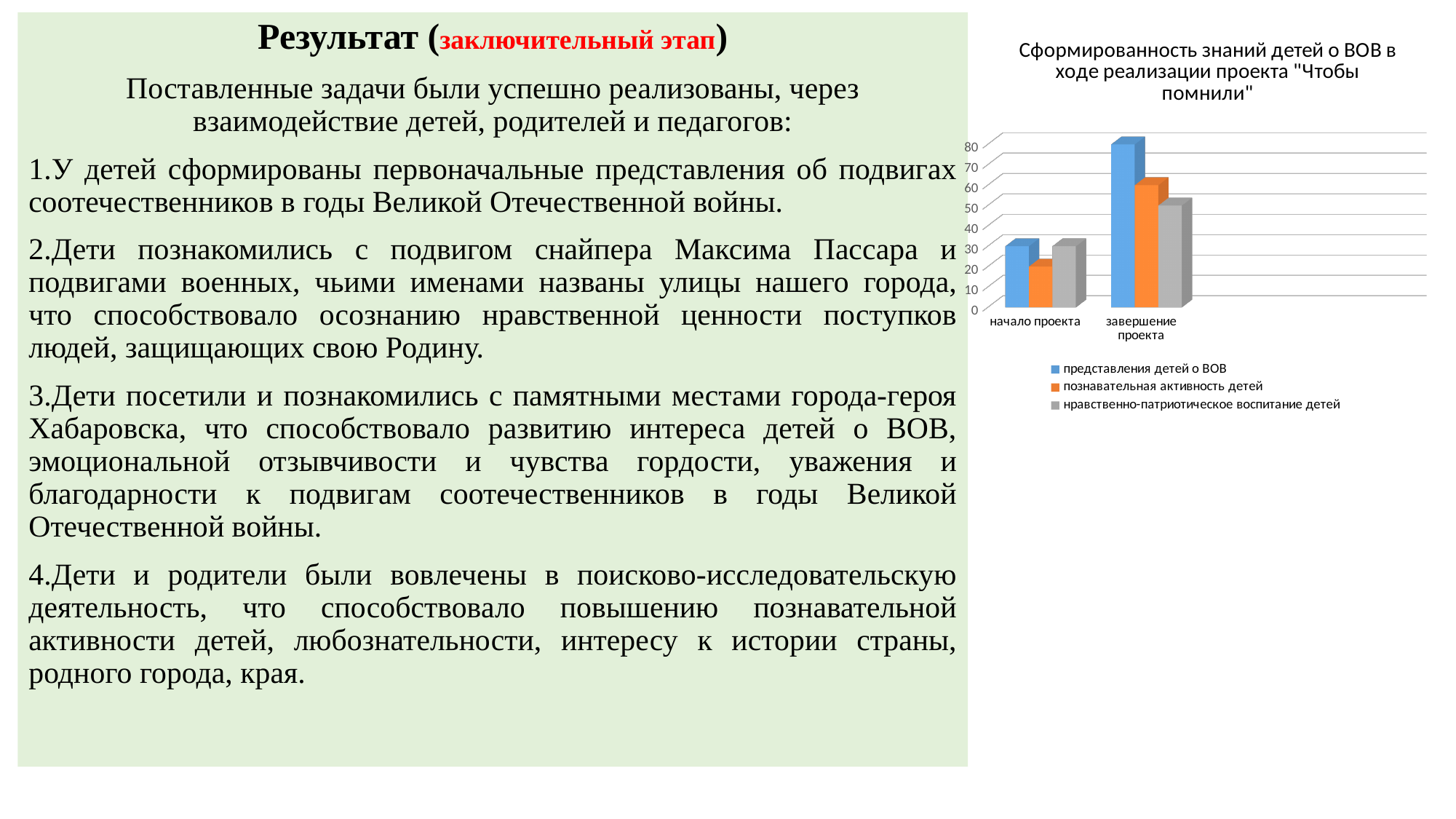
For "представления детей о ВОВ", which category has the larger value: "начало проекта" or "завершение проекта"? завершение проекта Do the values for each series rise or fall from "начало проекта" to "завершение проекта"? rise Is the value for "представления детей о ВОВ" at "завершение проекта" greater or less than 70? greater Which series has the highest value for "завершение проекта"? представления детей о ВОВ How many categories are shown on the x axis of the chart? 2 How many series does the chart legend list? 3 Is the value for "познавательная активность детей" at "завершение проекта" greater or less than 50? greater What kind of chart is shown on the slide? bar chart Which series has the lowest value for "начало проекта"? познавательная активность детей Is the value for "познавательная активность детей" at "начало проекта" greater or less than 30? less Which series is shown in orange in the chart? познавательная активность детей